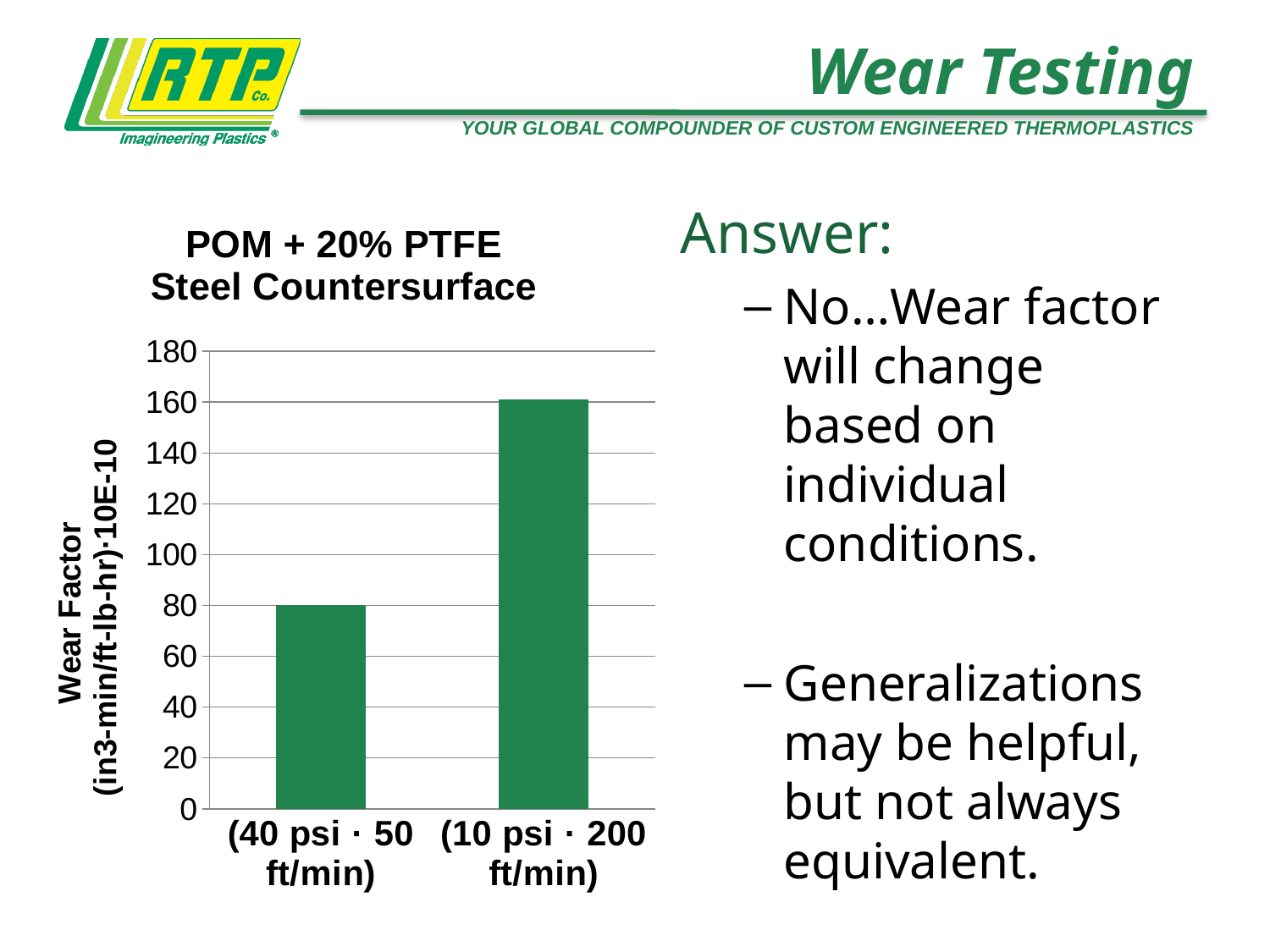
Which condition has the higher wear factor? (10 psi · 200 ft/min) Is the wear factor for (40 psi · 50 ft/min) greater or less than 100? less Is the wear factor for (10 psi · 200 ft/min) greater or less than 180? less Do the values rise or fall from the left bar to the right bar? rise Which condition has the lower wear factor? (40 psi · 50 ft/min) Is the wear factor for (10 psi · 200 ft/min) greater or less than 140? greater What is the label of the vertical axis? Wear Factor (in3-min/ft-lb-hr)·10E-10 What is the title of the chart? POM + 20% PTFE Steel Countersurface What is the wear factor for the (40 psi · 50 ft/min) condition? 80 Which is larger, the wear factor at (40 psi · 50 ft/min) or at (10 psi · 200 ft/min)? (10 psi · 200 ft/min) How many bars are plotted in the chart? 2 What kind of chart is shown on the slide? bar chart